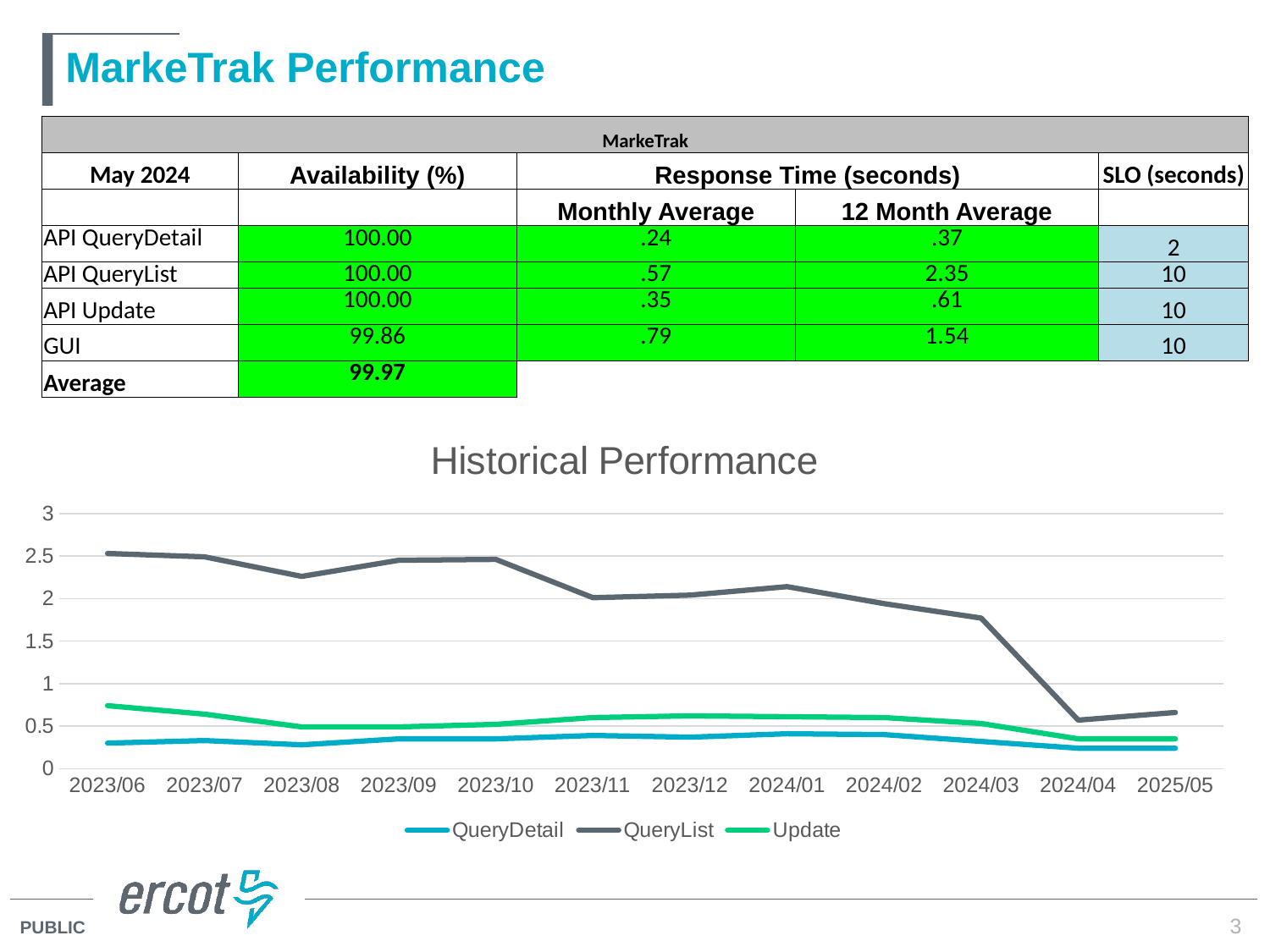
Which series are listed in the legend of the Historical Performance chart? QueryDetail, QueryList, Update In the Historical Performance chart, is the Update value at 2023/06 greater or less than 0.5? greater In the Historical Performance chart, is the QueryList value at 2024/04 greater or less than 1? less In the Historical Performance chart, which series has the higher value at 2023/10, QueryList or QueryDetail? QueryList In the Historical Performance chart, is the QueryDetail value at 2023/06 greater or less than 0.5? less In the Historical Performance chart, which series has the highest values across the period shown? QueryList In the Historical Performance chart, does the QueryList series rise or fall from 2023/06 to 2025/05? fall What is the title of the line chart on the slide? Historical Performance How many points along the x axis does the Historical Performance chart show? 12 What kind of chart is the Historical Performance chart? line chart How many series does the legend of the Historical Performance chart list? 3